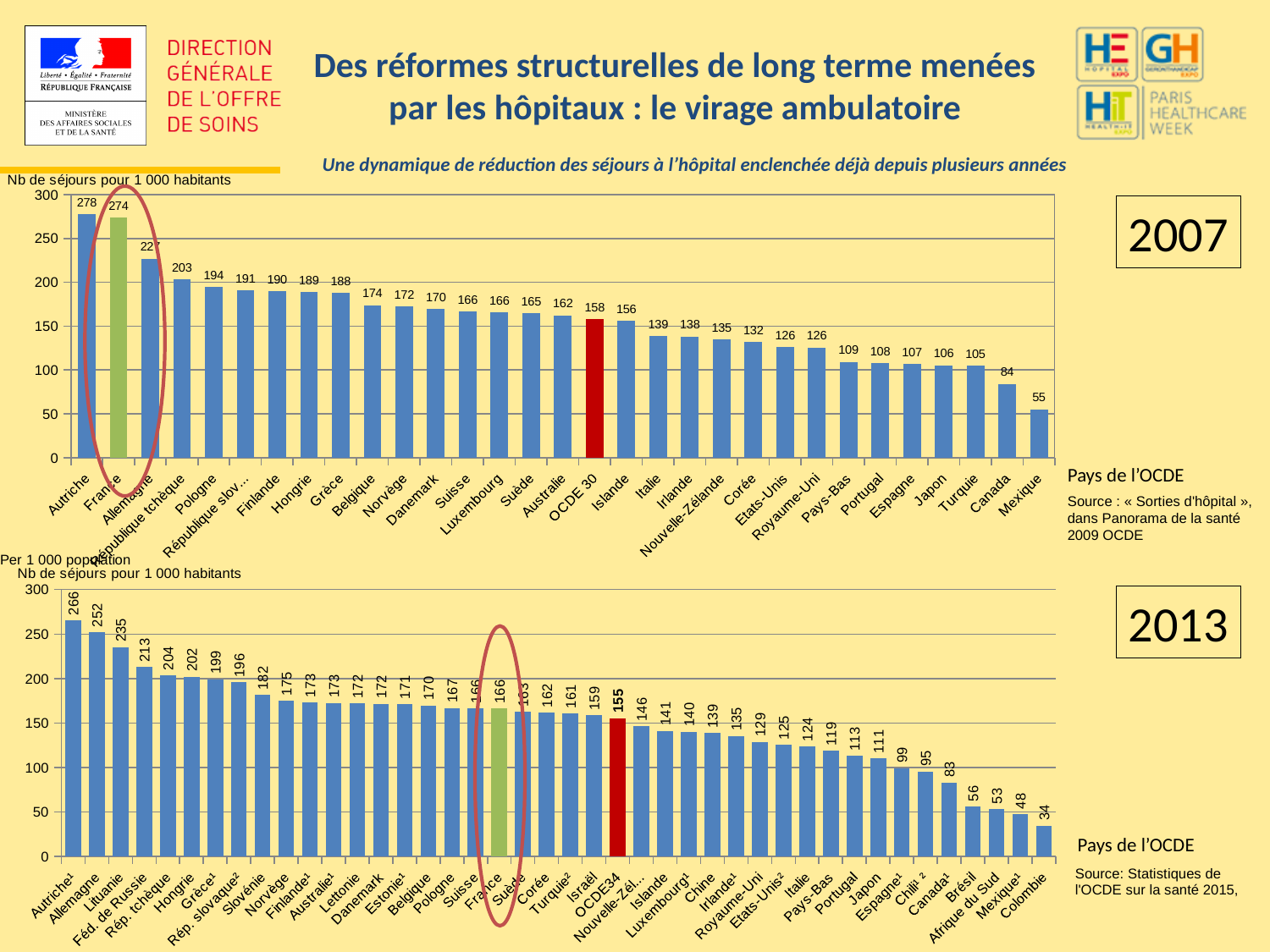
In the 2013 chart, which country has the lowest value? Colombie What type of chart is the 2013 chart? Bar chart In the 2013 chart, what is the value for France? 166 In the 2007 chart, what is the value for France? 274 What is the difference between the value for France in the 2007 chart and the value for France in the 2013 chart? 108 In the 2013 chart, do the values rise or fall from left to right along the x axis? Fall In the 2007 chart, what is the value for OCDE 30? 158 In the 2013 chart, which is larger: the value for Allemagne or the value for France? Allemagne In the 2013 chart, what is the value for OCDE34? 155 In the 2007 chart, which country has the highest number of stays per 1 000 inhabitants? Autriche How many bars are shown in the 2007 chart? 31 In the 2007 chart, which country has the lowest value? Mexique